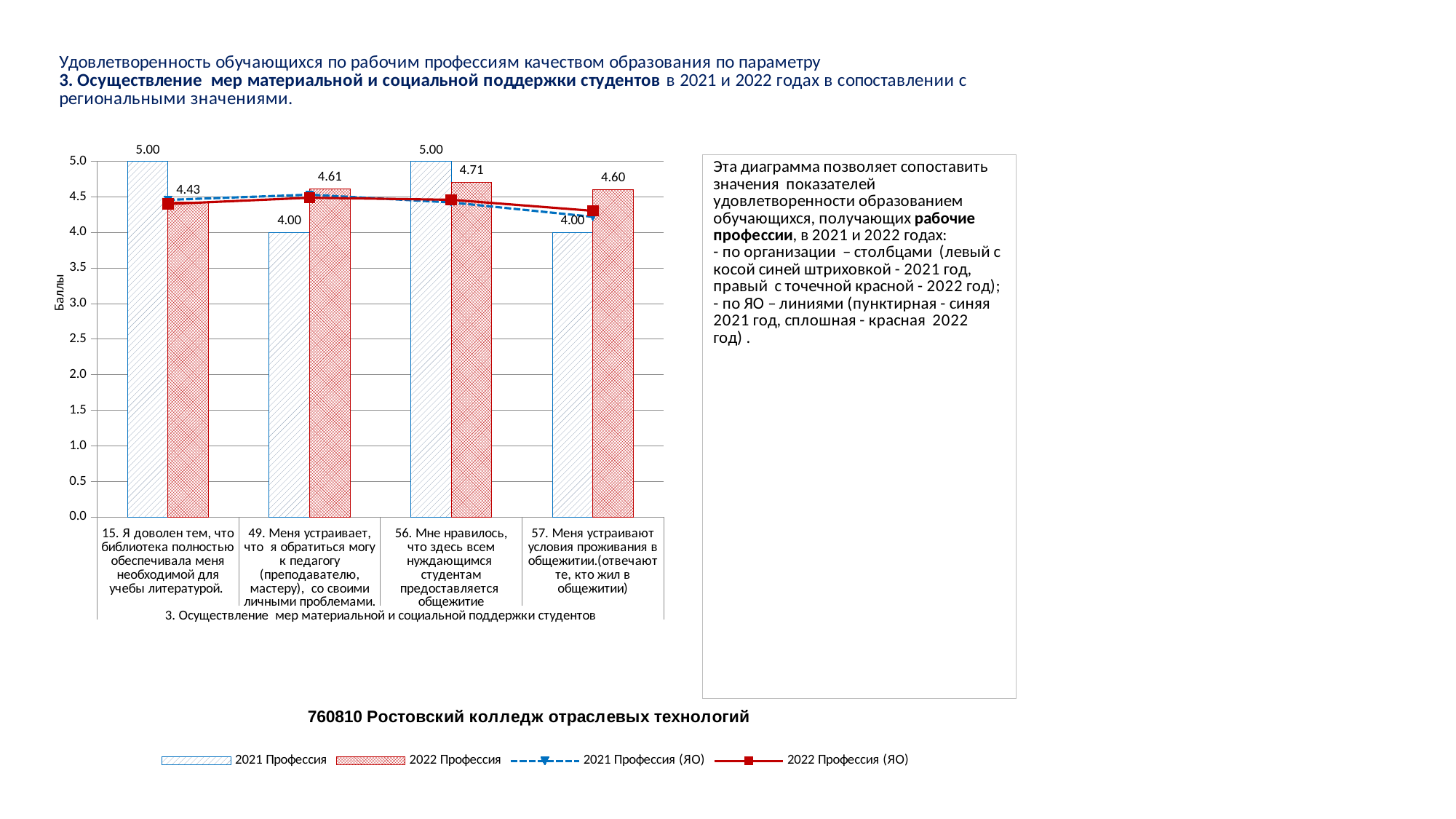
Which question has the highest 2022 Профессия bar? 56. Мне нравилось, что здесь всем нуждающимся студентам предоставляется общежитие What is the value of the 2021 Профессия bar for question 49 (Меня устраивает, что я обратиться могу к педагогу)? 4.00 What is the label of the vertical axis of the chart? Баллы What is the value of the 2022 Профессия bar for question 57 (Меня устраивают условия проживания в общежитии)? 4.60 How many questions (categories) are shown on the x axis of the chart? 4 How many series does the chart legend list? 4 What is the value of the 2022 Профессия bar for question 15 (Я доволен тем, что библиотека полностью обеспечивала меня необходимой для учебы литературой)? 4.43 Is the 2022 Профессия (ЯО) line value for question 15 greater or less than 4.0? greater For question 49, which bar is larger: 2021 Профессия or 2022 Профессия? 2022 Профессия Which question has the lowest 2022 Профессия bar? 15. Я доволен тем, что библиотека полностью обеспечивала меня необходимой для учебы литературой What is the difference between the 2021 Профессия and 2022 Профессия bars for question 15? 0.57 What is the value of the 2022 Профессия bar for question 56 (Мне нравилось, что здесь всем нуждающимся студентам предоставляется общежитие)? 4.71